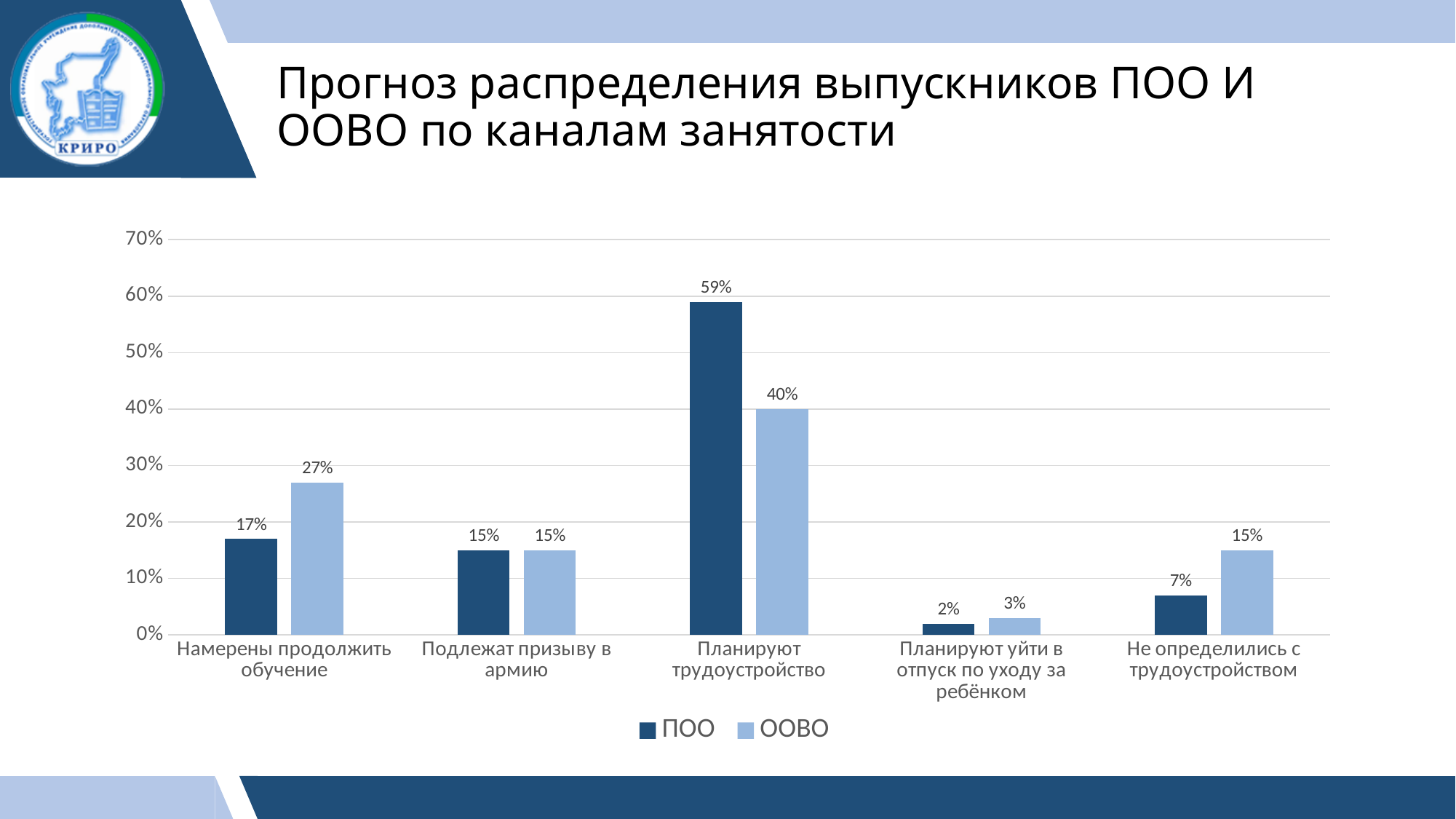
What is the value for ООВО in the category 'Намерены продолжить обучение'? 27% Which category has the lowest value for the ООВО series? Планируют уйти в отпуск по уходу за ребёнком What is the difference between the ПОО and ООВО values in the category 'Планируют трудоустройство'? 19% Which category has the highest value for the ПОО series? Планируют трудоустройство In the category 'Намерены продолжить обучение', which series has the larger value, ПОО or ООВО? ООВО How many series does the legend list? 2 What are the two series named in the legend? ПОО and ООВО What kind of chart is shown on the slide? Bar chart What is the value for ООВО in the category 'Планируют уйти в отпуск по уходу за ребёнком'? 3% What is the value for ПОО in the category 'Планируют трудоустройство'? 59% What is the value for ПОО in the category 'Не определились с трудоустройством'? 7% How many categories are shown on the x axis? 5